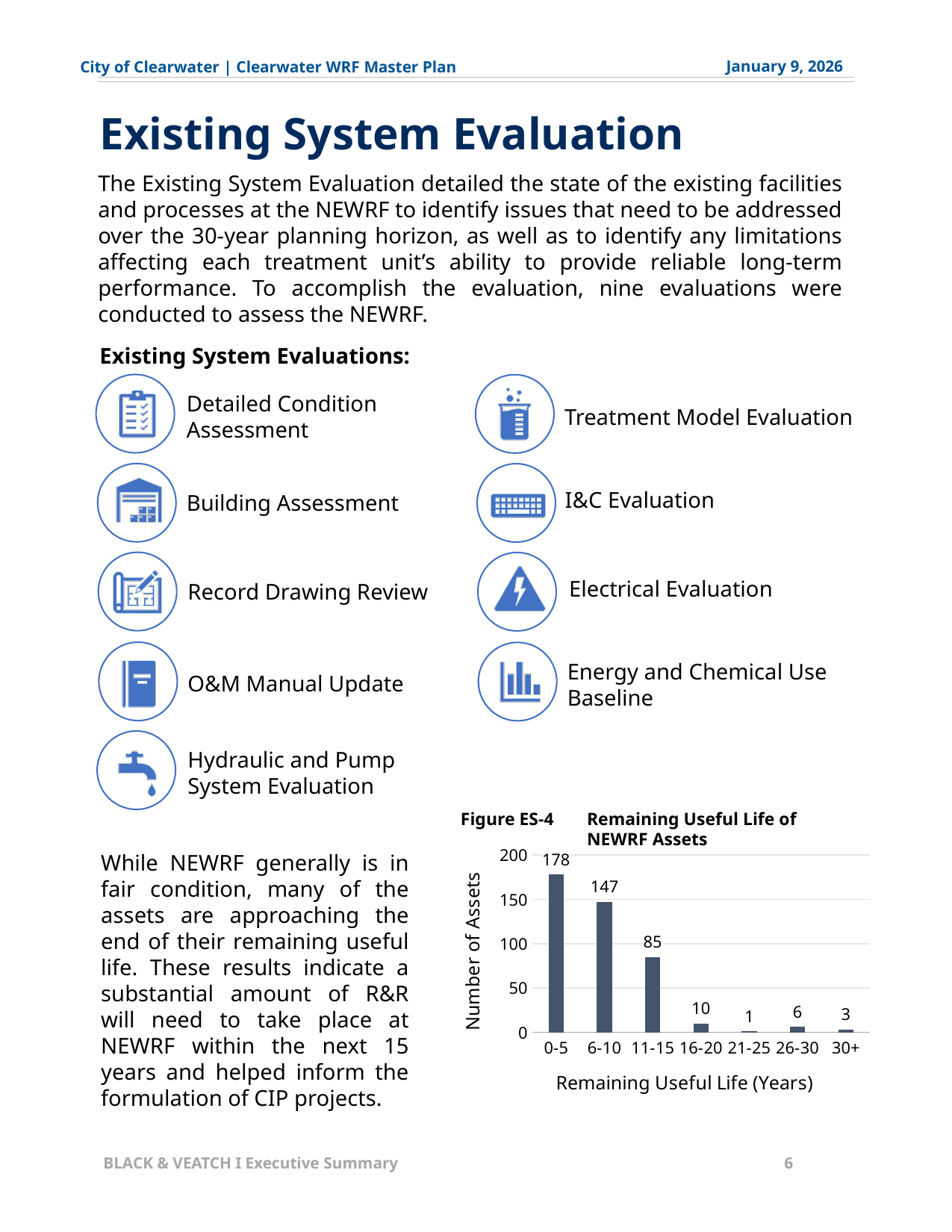
Which remaining useful life category has the lowest number of assets? 21-25 Do the values generally rise or fall as remaining useful life increases along the x axis? Fall What type of chart is Figure ES-4? Bar chart What is the difference in number of assets between the 0-5 and 6-10 categories? 31 Which category has more assets, 26-30 or 30+? 26-30 Which remaining useful life category has the highest number of assets? 0-5 How many assets fall in the 21-25 years category? 1 Is the value for the 6-10 category greater or less than 100? greater How many assets have a remaining useful life of 0-5 years? 178 What is the number of assets in the 11-15 years remaining useful life category? 85 What is the label of the y axis in Figure ES-4? Number of Assets How many remaining useful life categories are shown on the x axis? 7